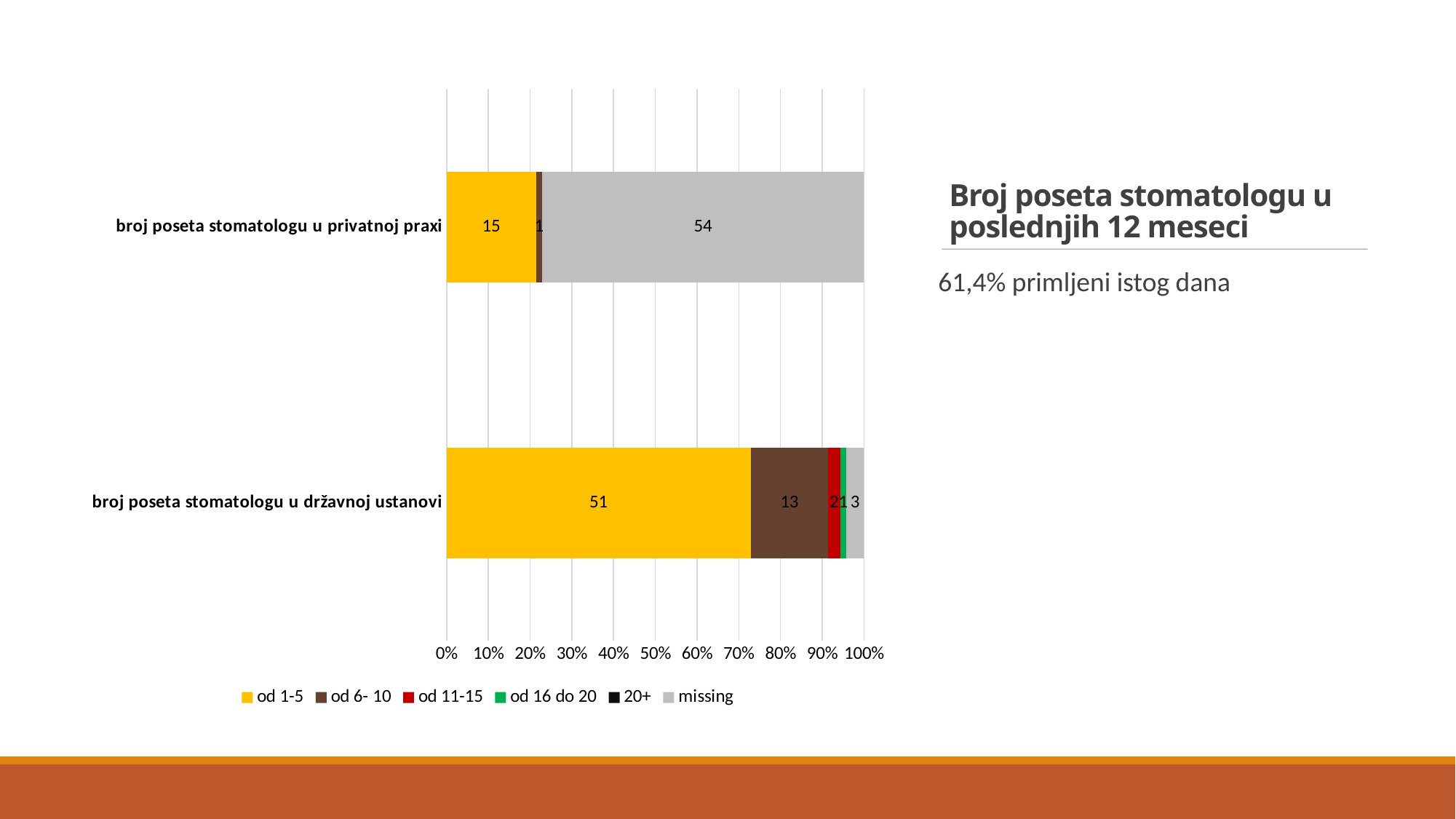
What is the value of the 'missing' segment for 'broj poseta stomatologu u državnoj ustanovi'? 3 What kind of chart is shown on the slide? Stacked bar chart What is the value of the 'od 6- 10' segment for 'broj poseta stomatologu u državnoj ustanovi'? 13 What is the value of the 'missing' segment for 'broj poseta stomatologu u privatnoj praxi'? 54 Which bar has the larger 'missing' value, privatnoj praxi or državnoj ustanovi? broj poseta stomatologu u privatnoj praxi How many series does the legend list? 6 How many categories (bars) are shown in the chart? 2 What is the title shown next to the chart? Broj poseta stomatologu u poslednjih 12 meseci What is the difference between the 'od 1-5' values for the državnoj ustanovi bar and the privatnoj praxi bar? 36 What is the value of the 'od 1-5' segment for 'broj poseta stomatologu u privatnoj praxi'? 15 What is the value of the 'od 1-5' segment for 'broj poseta stomatologu u državnoj ustanovi'? 51 What is the total of all labelled segments in the 'broj poseta stomatologu u državnoj ustanovi' bar? 70